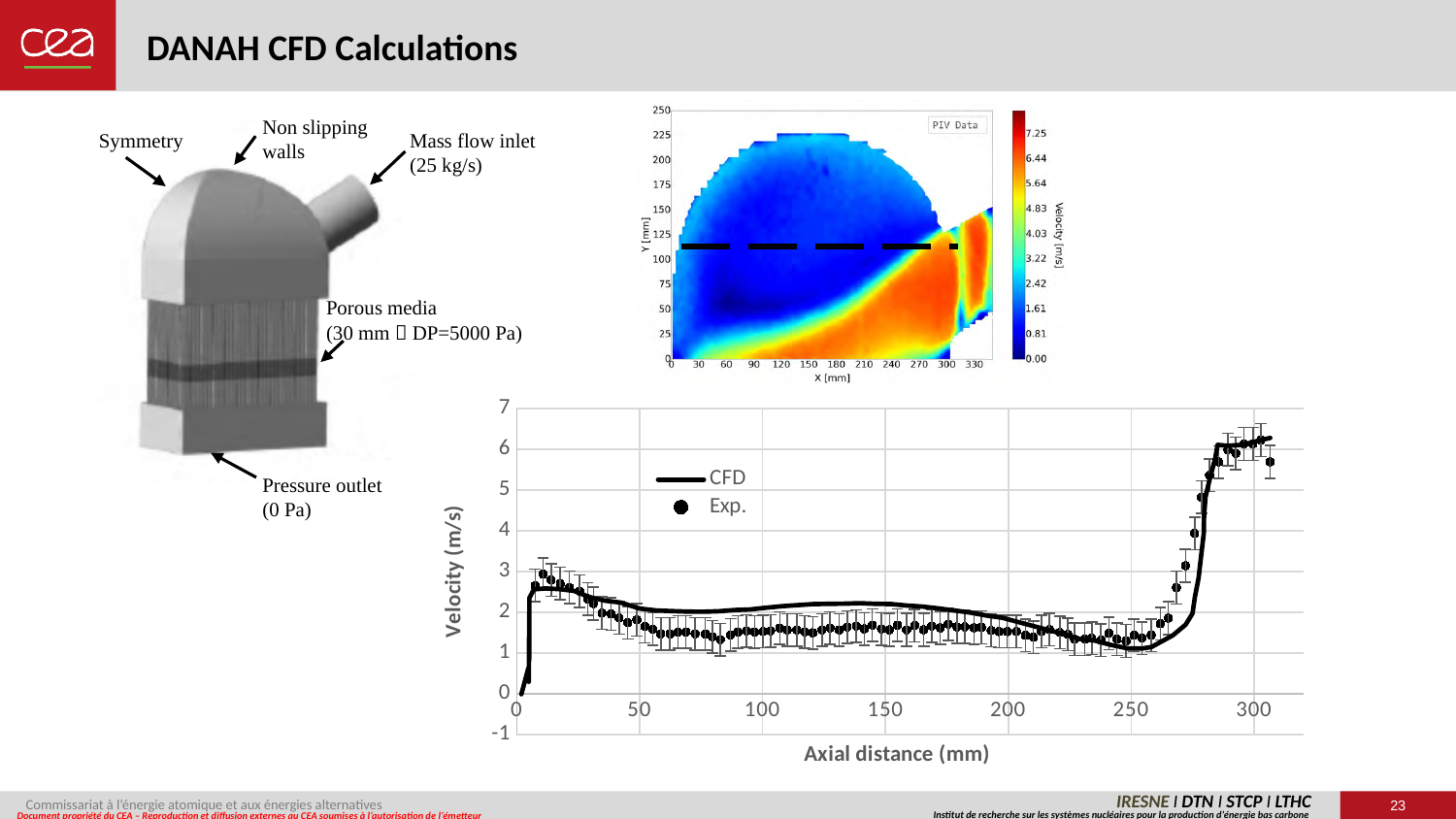
In the velocity chart, at which end of the axial distance axis does the CFD velocity reach its highest values? the right end, near 300 mm What kind of chart is the velocity versus axial distance chart at the bottom of the slide? line chart In the velocity chart, are the Exp. values near an axial distance of 10 mm greater or less than 2? greater In the velocity chart, does the CFD velocity rise or fall between axial distances of 250 mm and 300 mm? rise In the velocity chart, is the CFD value at an axial distance of 250 mm greater or less than 2? less What is the x-axis title of the velocity chart? Axial distance (mm) In the velocity chart, does the CFD velocity rise or fall between axial distances of 200 mm and 250 mm? fall How many series does the legend of the velocity chart list? 2 What are the two series named in the legend of the velocity chart? CFD and Exp. In the velocity chart, is the CFD value at an axial distance of 300 mm greater or less than 5? greater